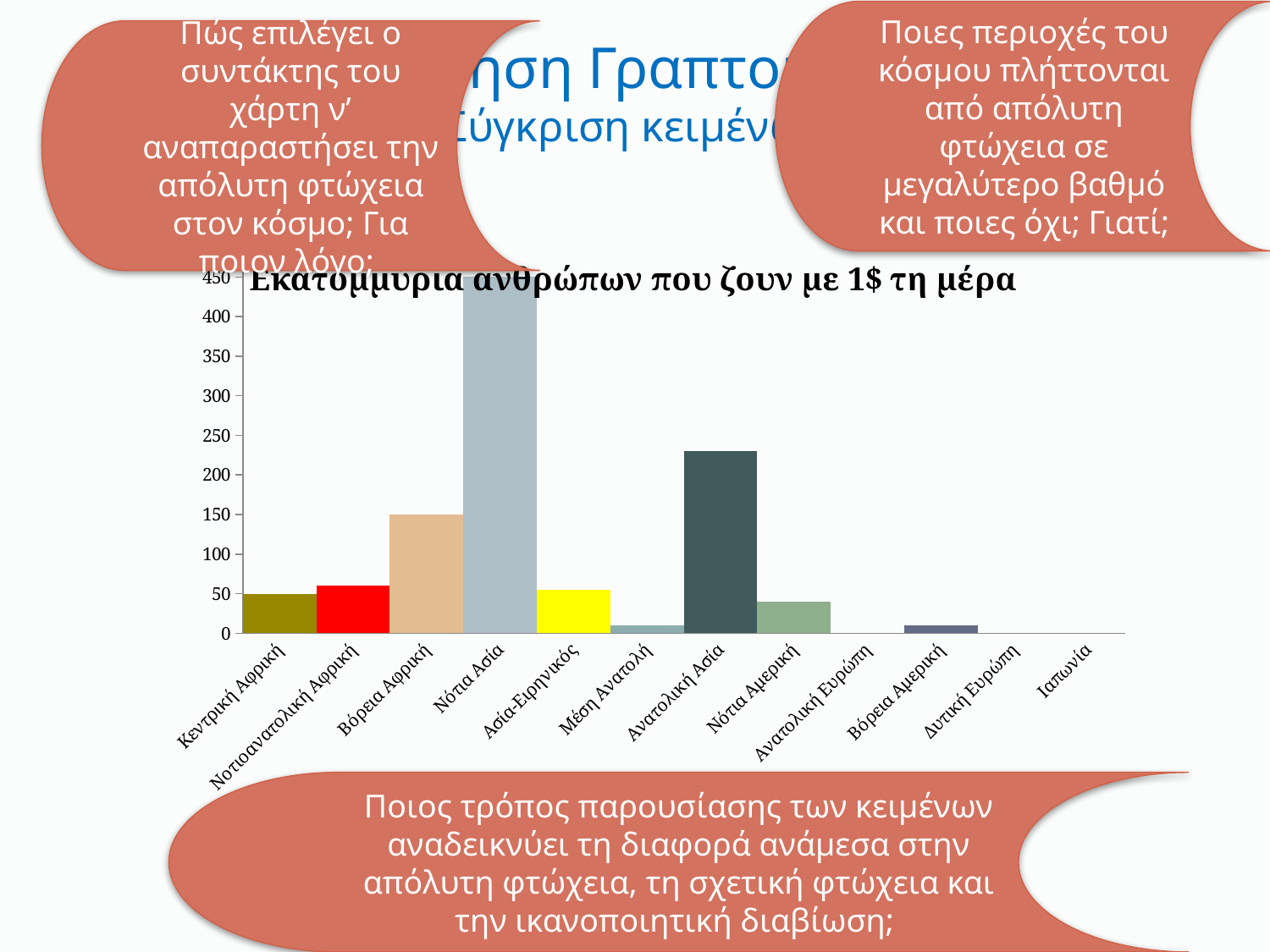
Is the value for Μέση Ανατολή greater or less than 50? less Which is larger, the value for Νοτιοανατολική Αφρική or the value for Μέση Ανατολή? Νοτιοανατολική Αφρική Is the value for Ανατολική Ασία greater or less than 200? greater Is the value for Νότια Αμερική greater or less than 100? less What is the title of the chart? Εκατομμύρια ανθρώπων που ζουν με 1$ τη μέρα How many regions (categories) are shown on the x axis of the chart? 12 What kind of chart is shown on the slide? bar chart Which is larger, the value for Ανατολική Ασία or the value for Βόρεια Αφρική? Ανατολική Ασία What colour is the bar for Νοτιοανατολική Αφρική? red Which region has the highest bar in the chart? Νότια Ασία